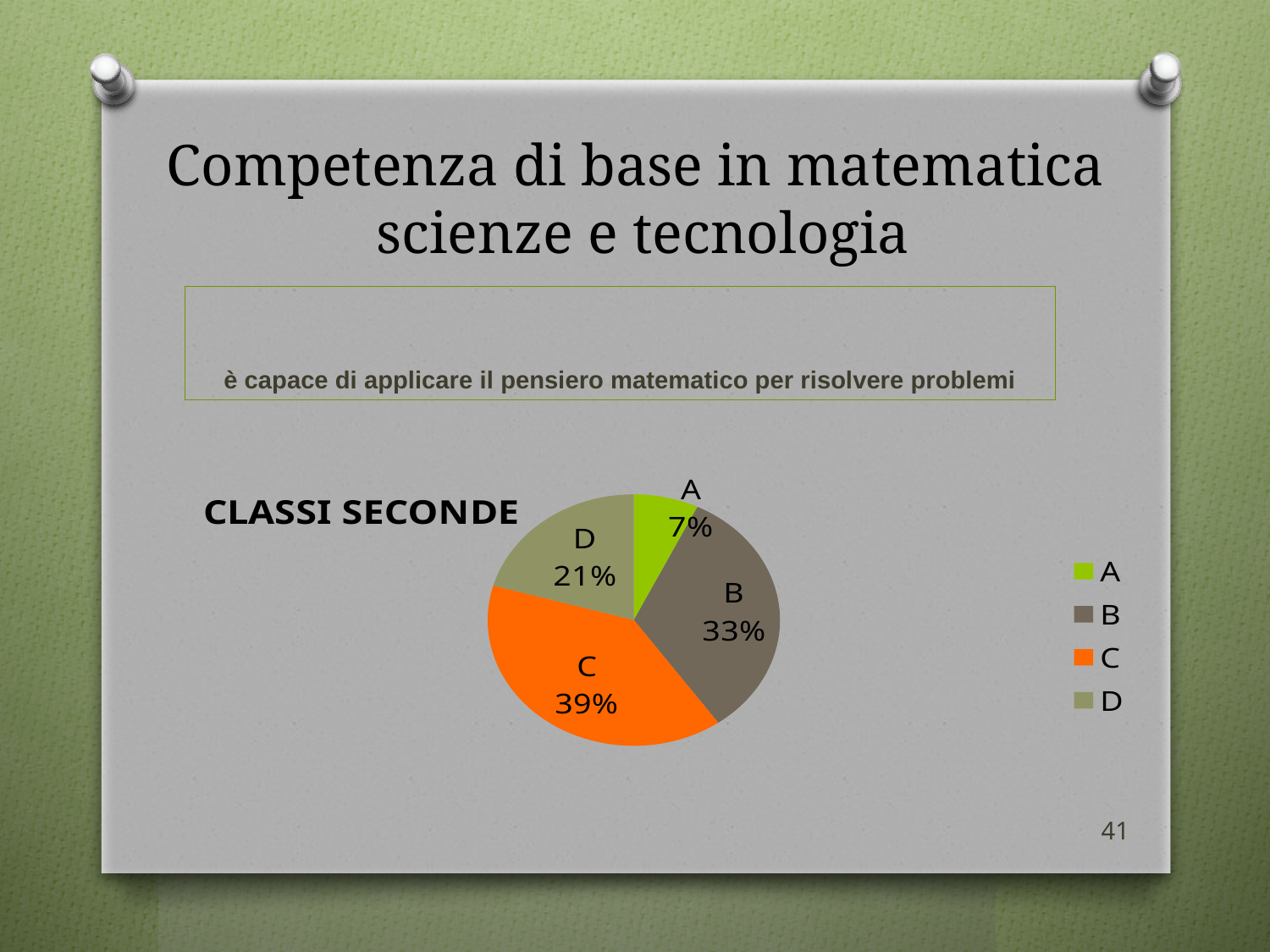
Which is larger, the slice for B or the slice for D? B What is the difference in percentage points between category D and category A? 14 What kind of chart is shown on the slide? pie chart Which category has the smallest slice in the pie chart? A What label appears to the left of the pie chart? CLASSI SECONDE What is the difference in percentage points between category C and category B? 6 What is the share for category C in the pie chart? 39% What is the share for category A in the pie chart? 7% What is the share for category D in the pie chart? 21% How many categories does the pie chart have? 4 Which category has the largest slice in the pie chart? C What is the share for category B in the pie chart? 33%